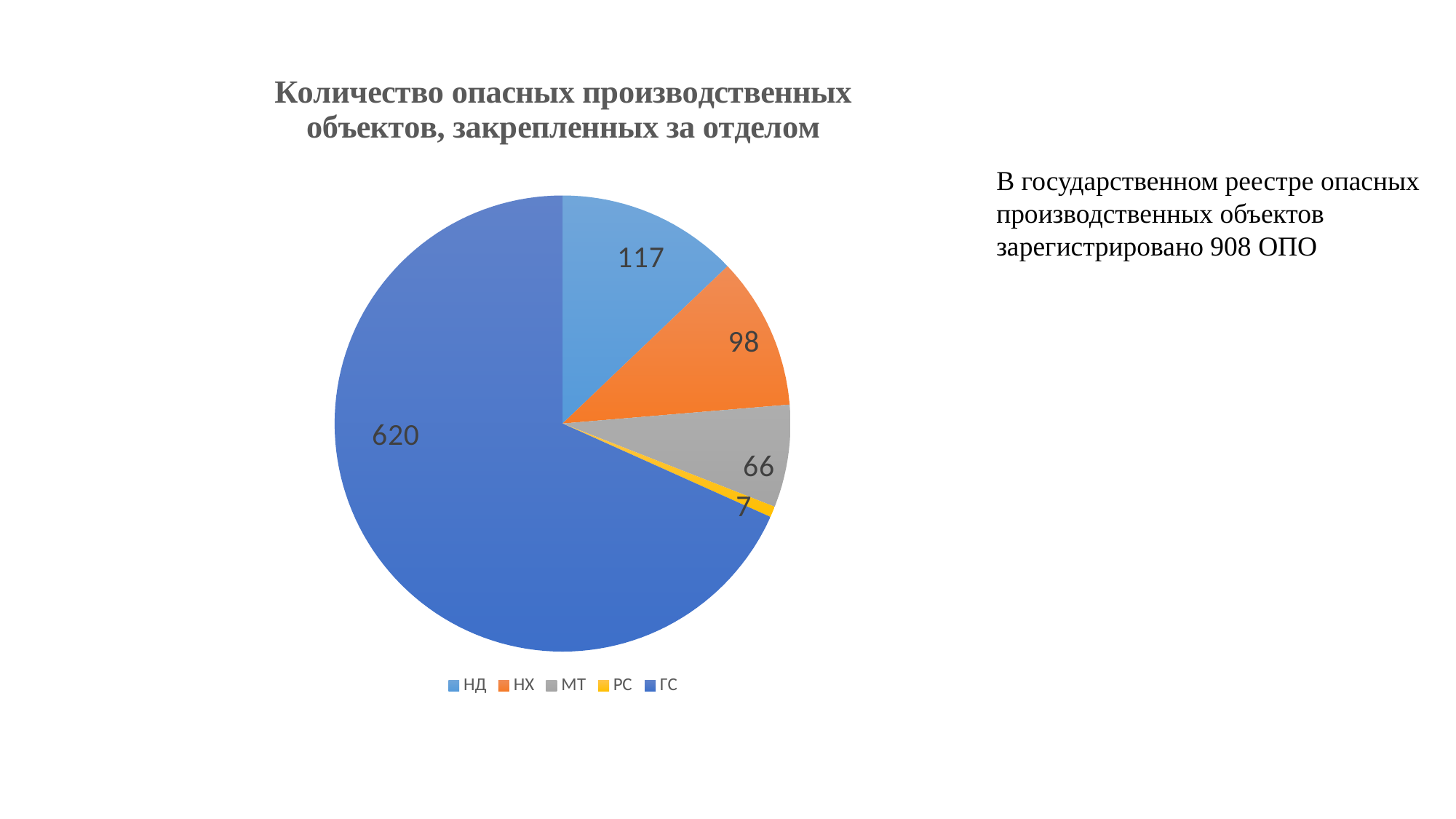
What is the value for РС in the pie chart? 7 What type of chart is shown on the slide? Pie chart What is the title of the chart? Количество опасных производственных объектов, закрепленных за отделом Which category has the largest slice in the pie chart? ГС What is the value for НХ in the pie chart? 98 Which category has the smallest slice in the pie chart? РС How many categories does the pie chart show? 5 What is the difference between the values for НД and НХ? 19 What is the value for ГС in the pie chart? 620 What is the value for НД in the pie chart? 117 Which is larger, the value for МТ or the value for НХ? НХ What is the value for МТ in the pie chart? 66